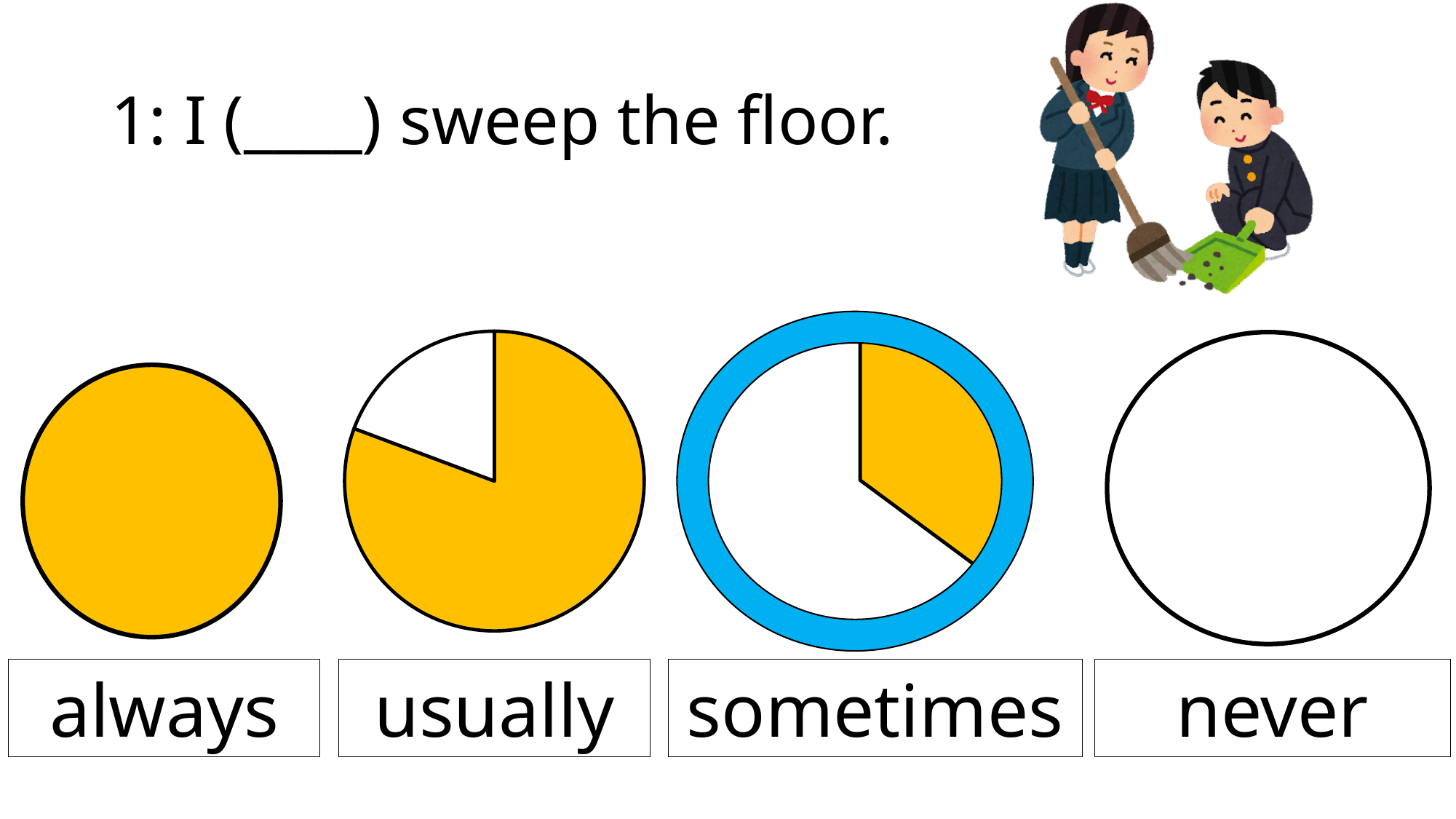
Which frequency word's pie chart is outlined with a thick blue ring? sometimes Which pie chart has a larger filled portion, the one labelled 'sometimes' or the one labelled 'never'? sometimes Reading the pie charts from left to right, does the filled portion increase or decrease? decrease What are the four labels under the pie charts, from left to right? always, usually, sometimes, never Which frequency word's pie chart has no filled portion at all? never Which pie chart has a larger filled portion, the one labelled 'always' or the one labelled 'usually'? always What kind of chart is used to show each frequency word on the slide? pie chart Which pie chart has a larger filled portion, the one labelled 'usually' or the one labelled 'sometimes'? usually How many pie charts are shown on the slide? 4 Which frequency word's pie chart is completely filled? always